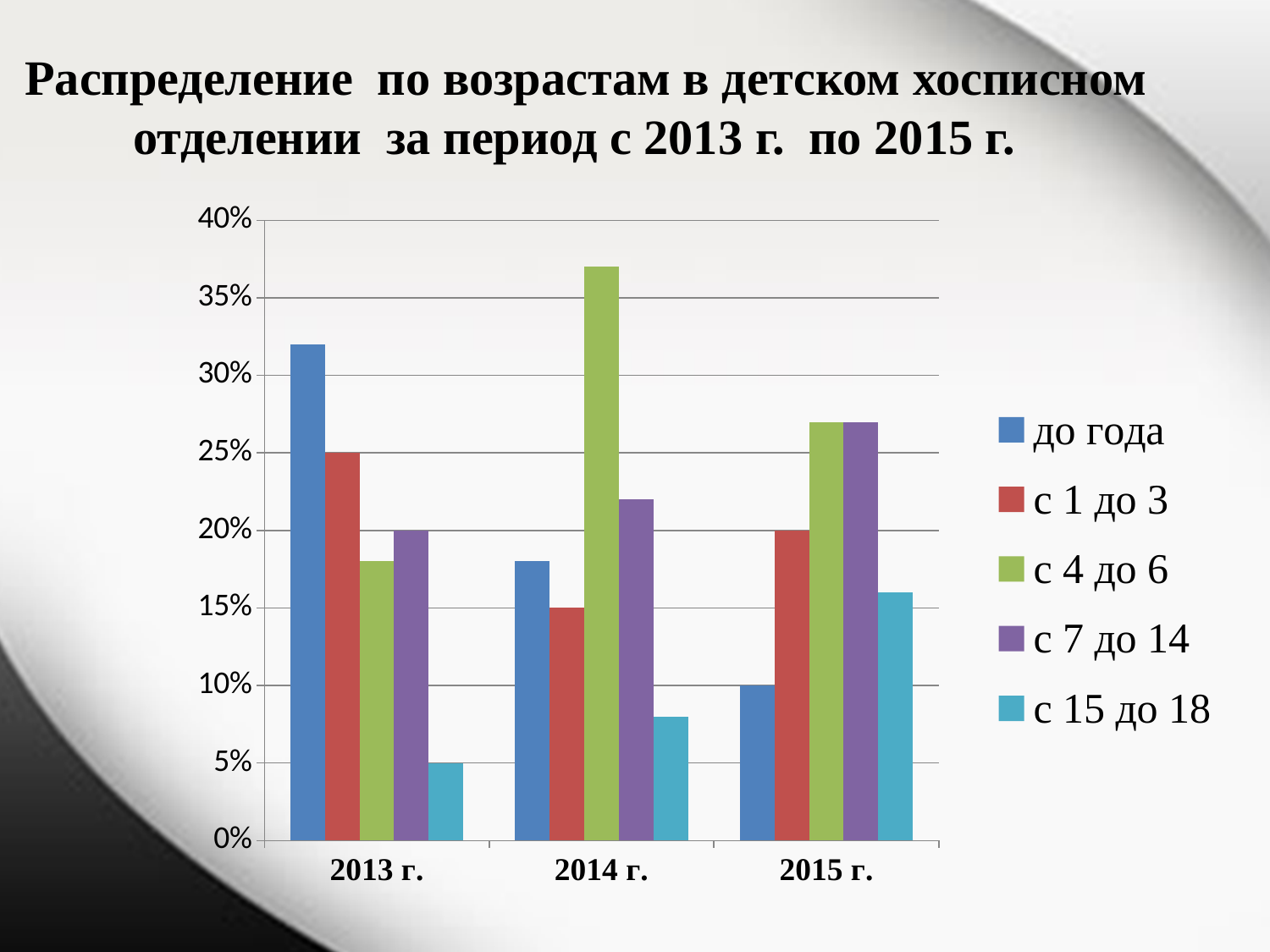
What is the value for "с 1 до 3" in 2013 г.? 25% What is the value for "до года" in 2015 г.? 10% Is the value for "с 4 до 6" in 2014 г. greater or less than 35%? greater What is the value for "с 15 до 18" in 2013 г.? 5% What type of chart is shown on the slide? bar chart Does the value for "до года" rise or fall from 2013 г. to 2015 г.? fall How many series does the legend list? 5 How many year categories are shown on the x axis? 3 Is the value for "с 15 до 18" in 2014 г. greater or less than 10%? less Which age group has the lowest value in 2014 г.? с 15 до 18 Which age group has the highest value in 2013 г.? до года What is the value for "с 1 до 3" in 2015 г.? 20%